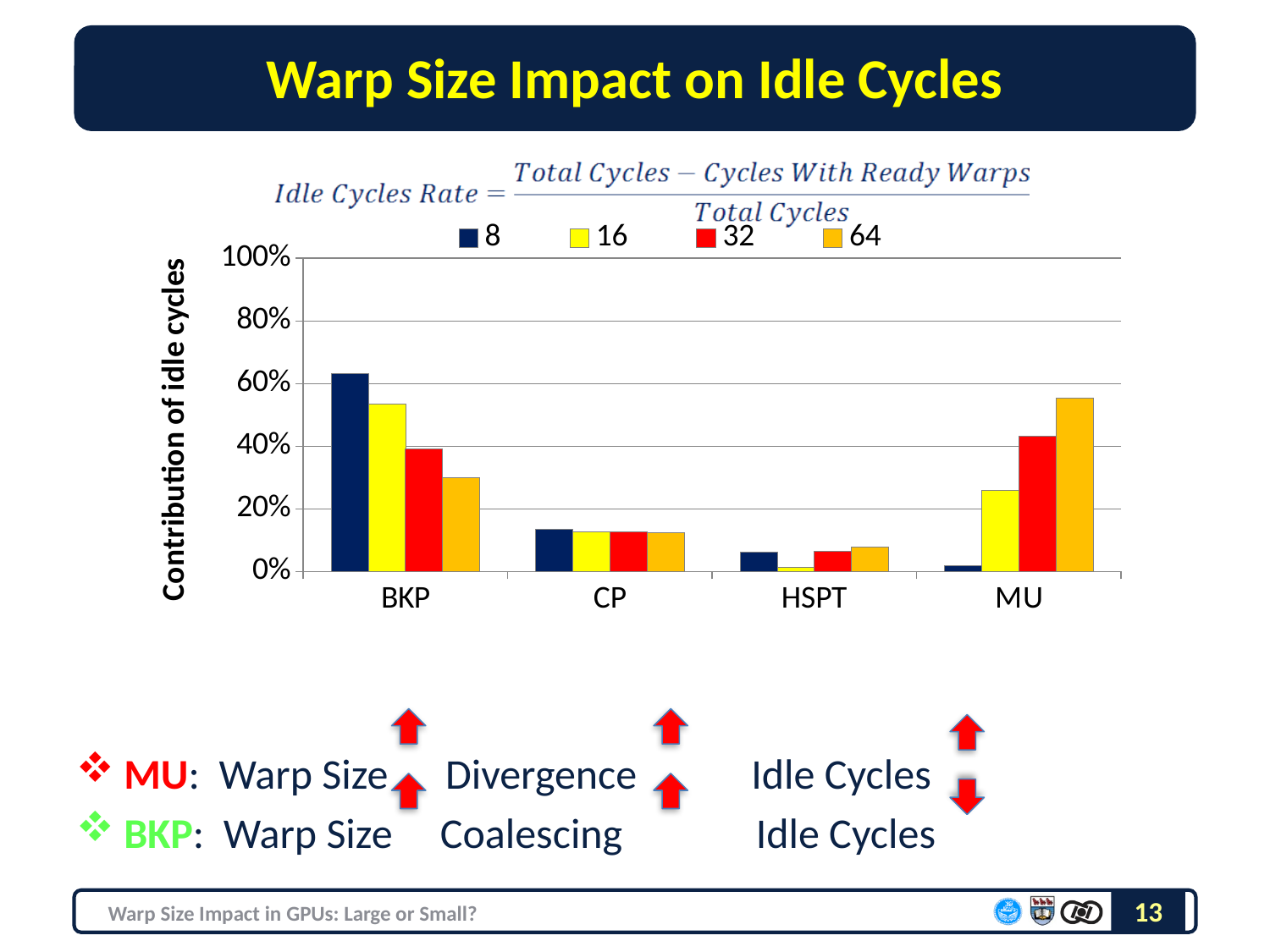
Is the value for MU at warp size 64 greater or less than 40%? greater For BKP, which is larger: the value for warp size 8 or the value for warp size 64? warp size 8 What is the title of the y axis? Contribution of idle cycles How many series does the legend list? 4 What kind of chart is shown on the slide? bar chart For MU, do the bars rise or fall as warp size increases from 8 to 64? rise Is the value for BKP at warp size 8 greater or less than 40%? greater Which benchmark has the highest contribution of idle cycles for warp size 8? BKP Is the value for CP at warp size 32 greater or less than 20%? less Which benchmark has the highest contribution of idle cycles for warp size 64? MU How many benchmark categories are shown on the x axis? 4 Which benchmark has the lowest contribution of idle cycles for warp size 16? HSPT